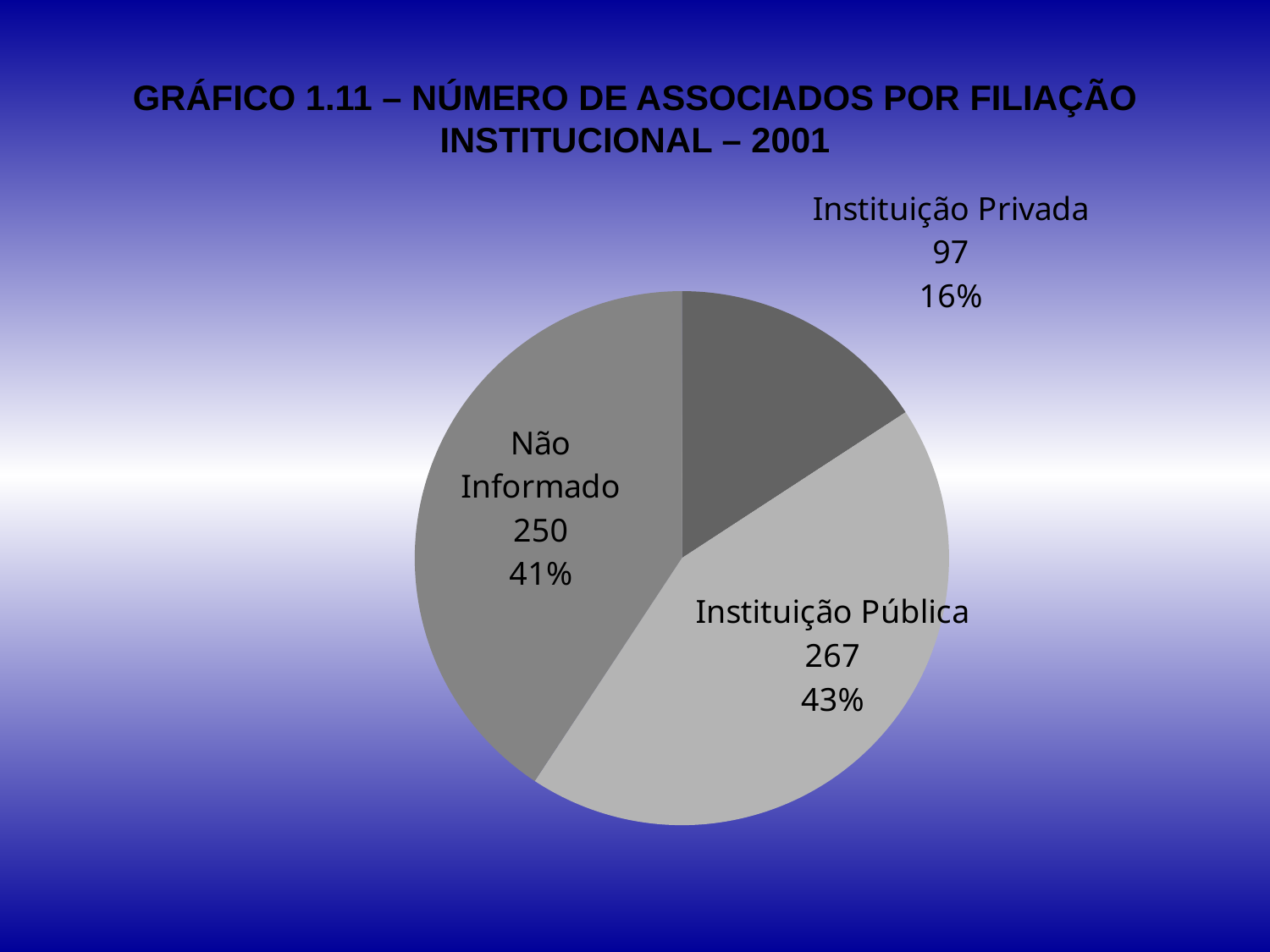
What percentage share does Não Informado have? 41% Which is larger, the value for Não Informado or the value for Instituição Privada? Não Informado What kind of chart is shown on the slide? pie chart Which category has the largest slice? Instituição Pública What percentage share does Instituição Privada have? 16% What is the number of associates for Instituição Privada? 97 What year does the chart title refer to? 2001 How many slices does the pie chart have? 3 What is the number of associates for Instituição Pública? 267 What is the difference between the values for Instituição Pública and Instituição Privada? 170 What is the number of associates for Não Informado? 250 Which category has the smallest slice? Instituição Privada